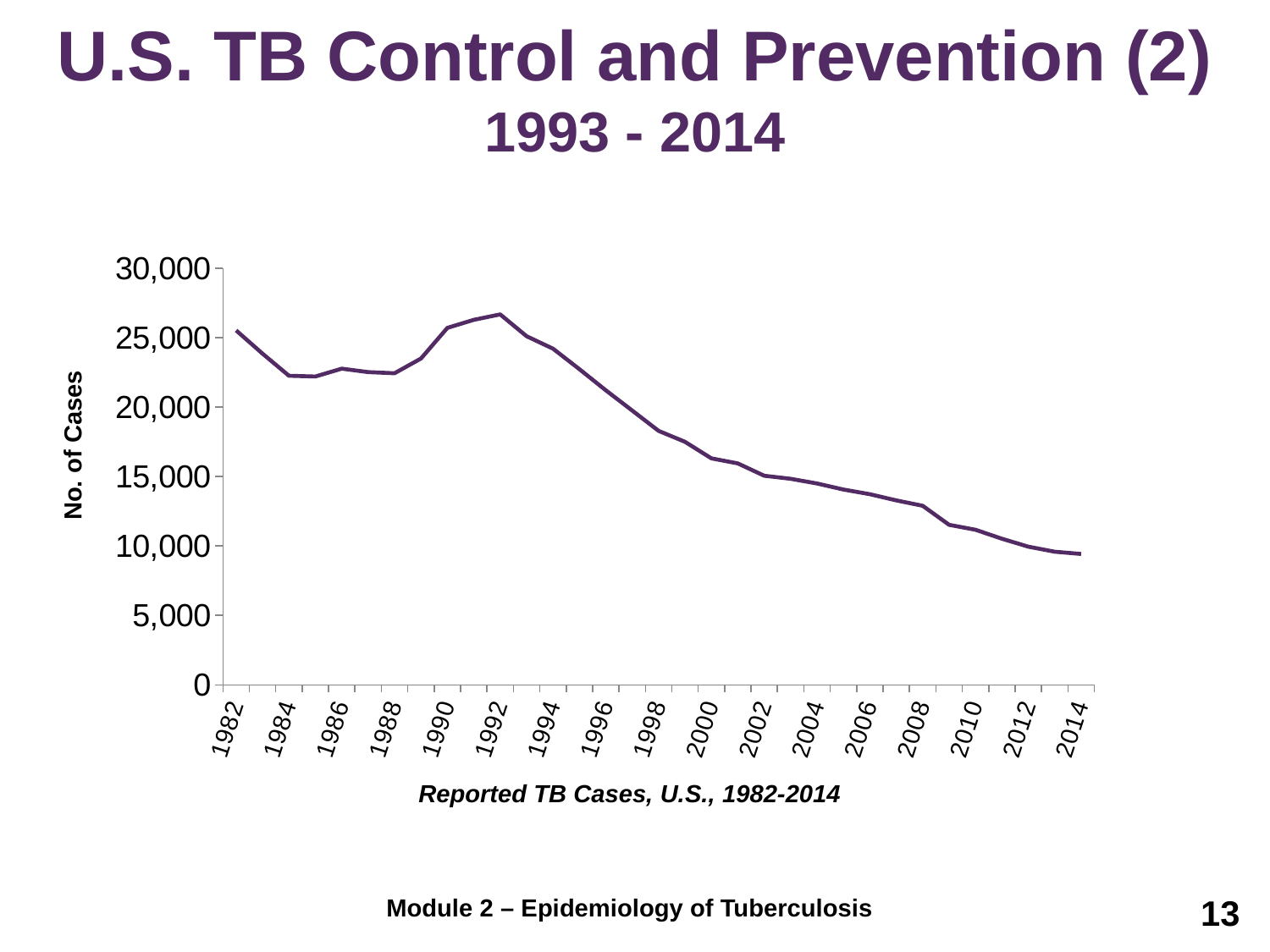
Is the value for 1984 greater or less than 20,000? greater In which year does the line reach its highest number of cases? 1992 Do the values rise or fall from 1992 to 2014? fall Is the value for 2014 greater or less than 10,000? less Is the value for 2008 greater or less than 15,000? less What is the label on the y axis? No. of Cases Which year has more reported cases, 1986 or 1996? 1986 What kind of chart is shown on the slide? line chart Which year has more reported cases, 1992 or 2002? 1992 How many year labels are shown on the x axis? 17